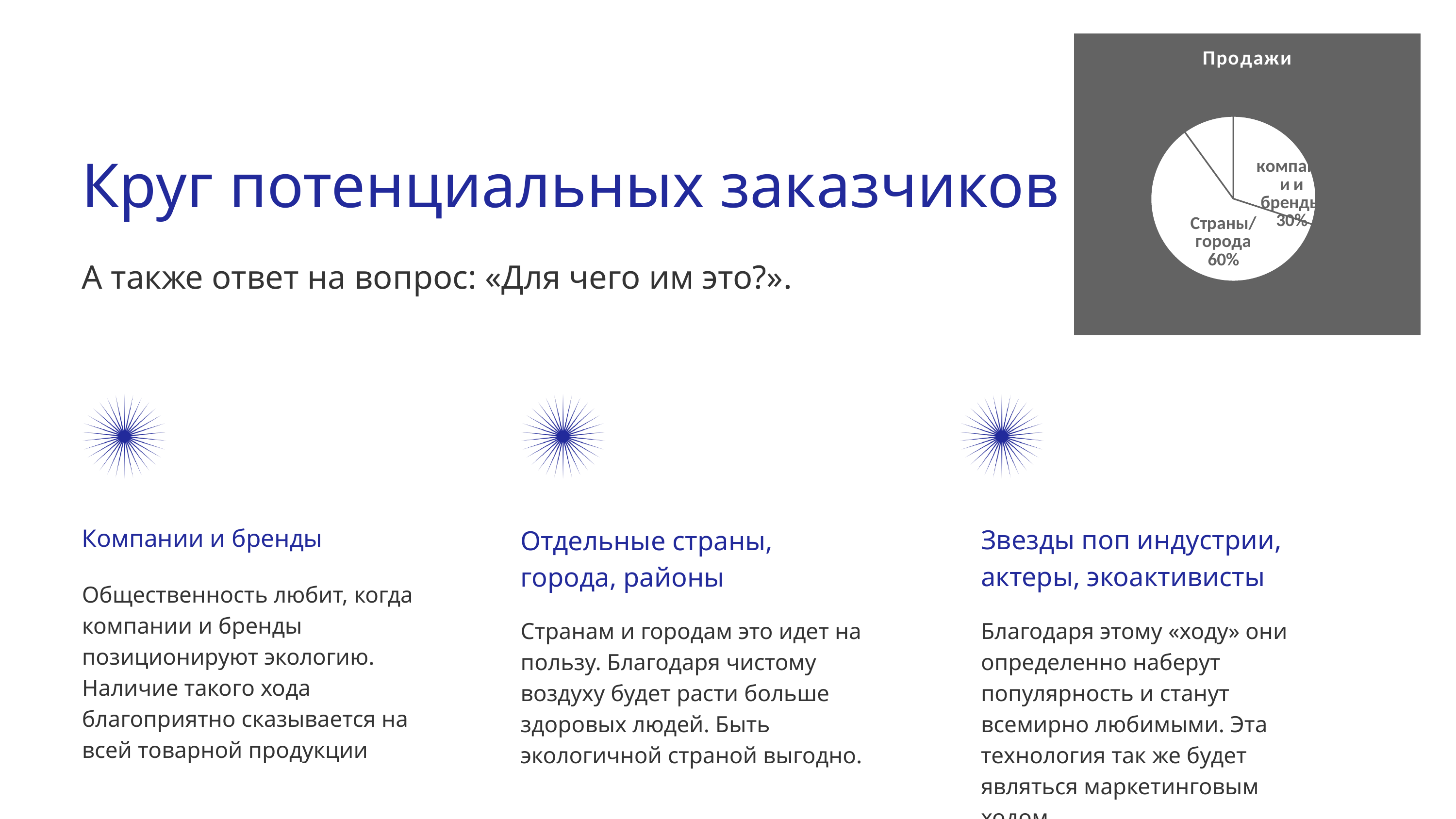
What value is shown for the slice "компании и бренды"? 30% Which is larger: the slice for "Страны/города" or the slice for "компании и бренды"? Страны/города What type of chart is shown on the slide? pie chart Which slice of the pie chart is the largest? Страны/города What is the title of the chart on the slide? Продажи What share of the pie does the slice "Страны/города" represent? 60% By how many percentage points does the "Страны/города" slice exceed the "компании и бренды" slice? 30 percentage points How many slices does the pie chart have? 3